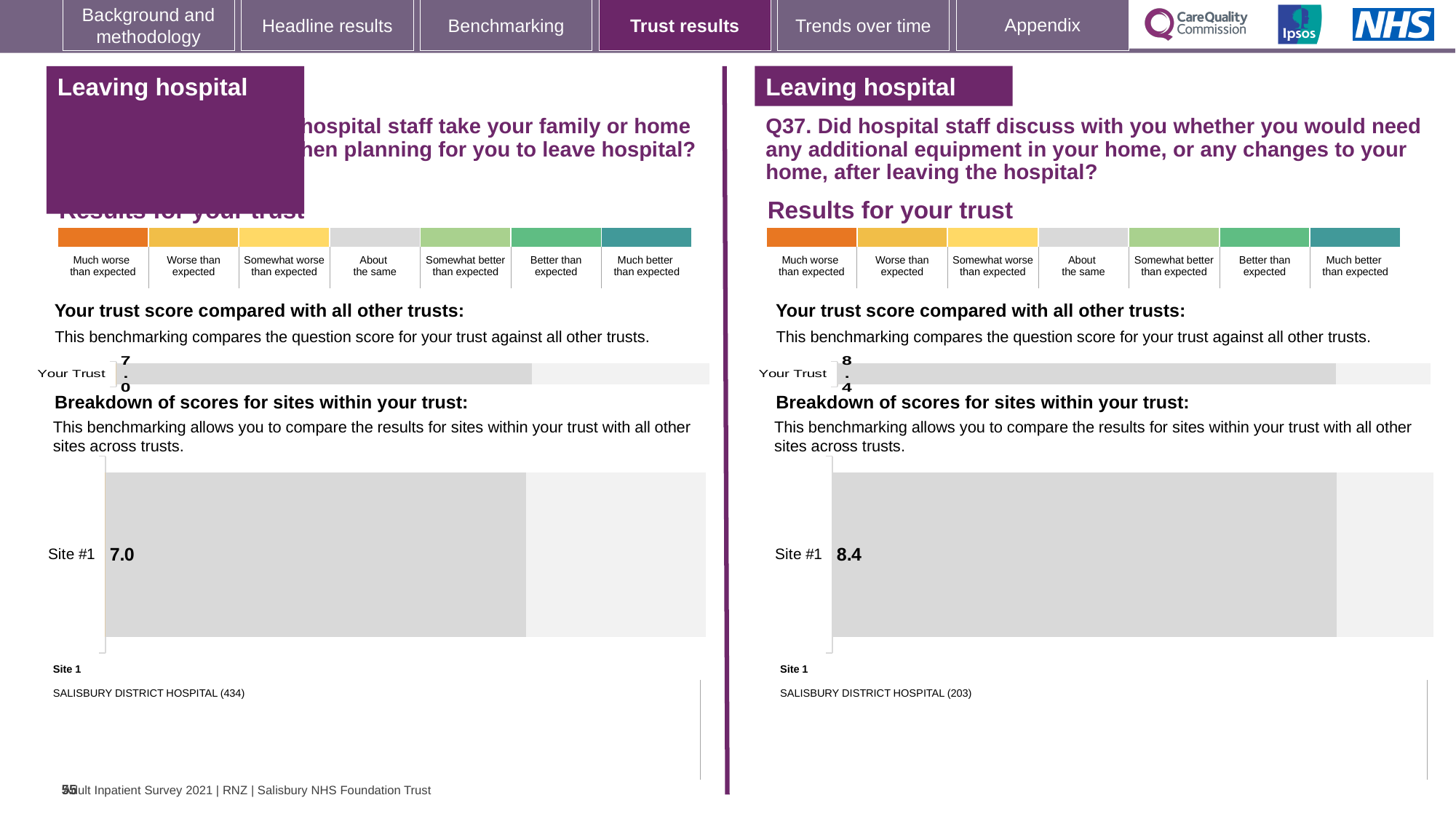
What kind of chart is used to show the breakdown of scores for sites within your trust on the right half of the slide? Bar chart What is the difference between the Site #1 score on the right half of the slide (Q37) and the Site #1 score on the left half? 1.4 How many sites are plotted in the breakdown of scores chart on the right half of the slide (Q37)? 1 How many sites are plotted in the breakdown of scores chart on the left half of the slide? 1 On the right half of the slide (Q37), what is the 'Your Trust' score in the chart comparing your trust score with all other trusts? 8.4 On the left half of the slide, which site name is listed under Site 1 below the breakdown chart? SALISBURY DISTRICT HOSPITAL (434) On the left half of the slide, what is the score shown for Site #1 in the breakdown of scores for sites within your trust? 7.0 Which Site #1 score is larger: the one on the left half of the slide or the one on the right half (Q37)? The right half (Q37) On the right half of the slide (Q37), what is the score shown for Site #1 in the breakdown of scores for sites within your trust? 8.4 On the right half of the slide (Q37), which site name is listed under Site 1 below the breakdown chart? SALISBURY DISTRICT HOSPITAL (203) On the left half of the slide, what is the 'Your Trust' score in the chart comparing your trust score with all other trusts? 7.0